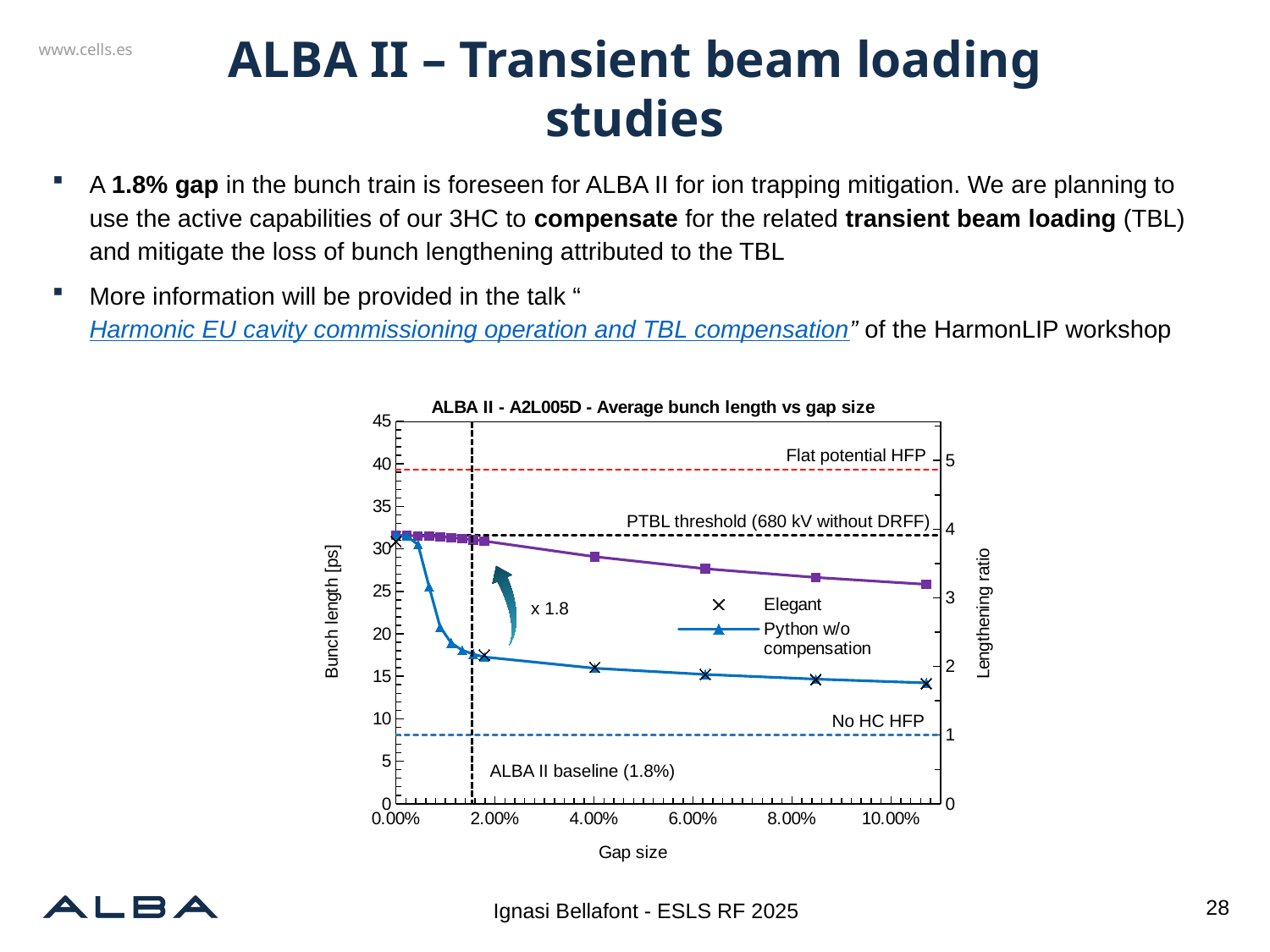
Does the Python w/o compensation series reach its lowest bunch length at the smallest or the largest gap size plotted? largest Is the bunch length of the Python w/o compensation series at a 6.00% gap greater or less than 20 ps? less How many series does the chart legend list? 2 Is the bunch length of the Python w/o compensation series at a 0.00% gap greater or less than 25 ps? greater As gap size increases, does the Python w/o compensation series rise or fall? fall Which two series are named in the chart legend? Elegant and Python w/o compensation What kind of chart is shown on the slide? line chart What is the title of the chart? ALBA II - A2L005D - Average bunch length vs gap size Is the Flat potential HFP dashed line above or below 35 ps on the left axis? above At which gap size does the Python w/o compensation series reach its highest bunch length? 0.00% Which is larger for the Python w/o compensation series: the bunch length at 0.00% gap or at the largest gap size plotted? 0.00% gap